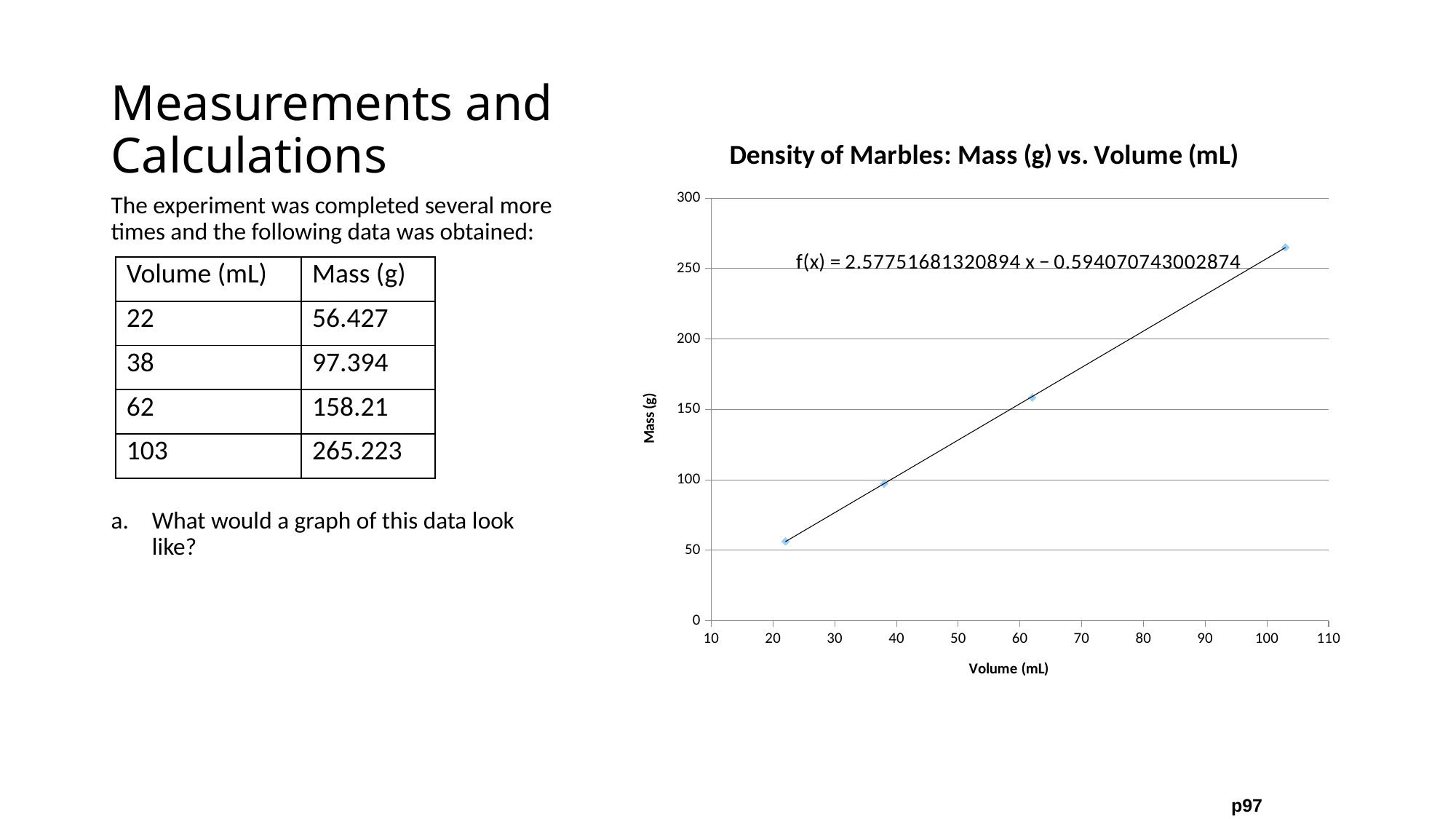
How many data points are plotted on the chart? 4 Which volume has the highest plotted mass? 103 Does the mass rise or fall as volume increases along the x axis? rise What is the mass (g) plotted for a volume of 103 mL? 265.223 Which volume has the lowest plotted mass? 22 What is the label of the y axis? Mass (g) Is the mass plotted for a volume of 103 mL greater or less than 250? greater What is the title of the chart? Density of Marbles: Mass (g) vs. Volume (mL) Is the mass plotted for a volume of 38 mL greater or less than 100? less What kind of chart is shown on the slide? scatter chart What is the mass (g) plotted for a volume of 22 mL? 56.427